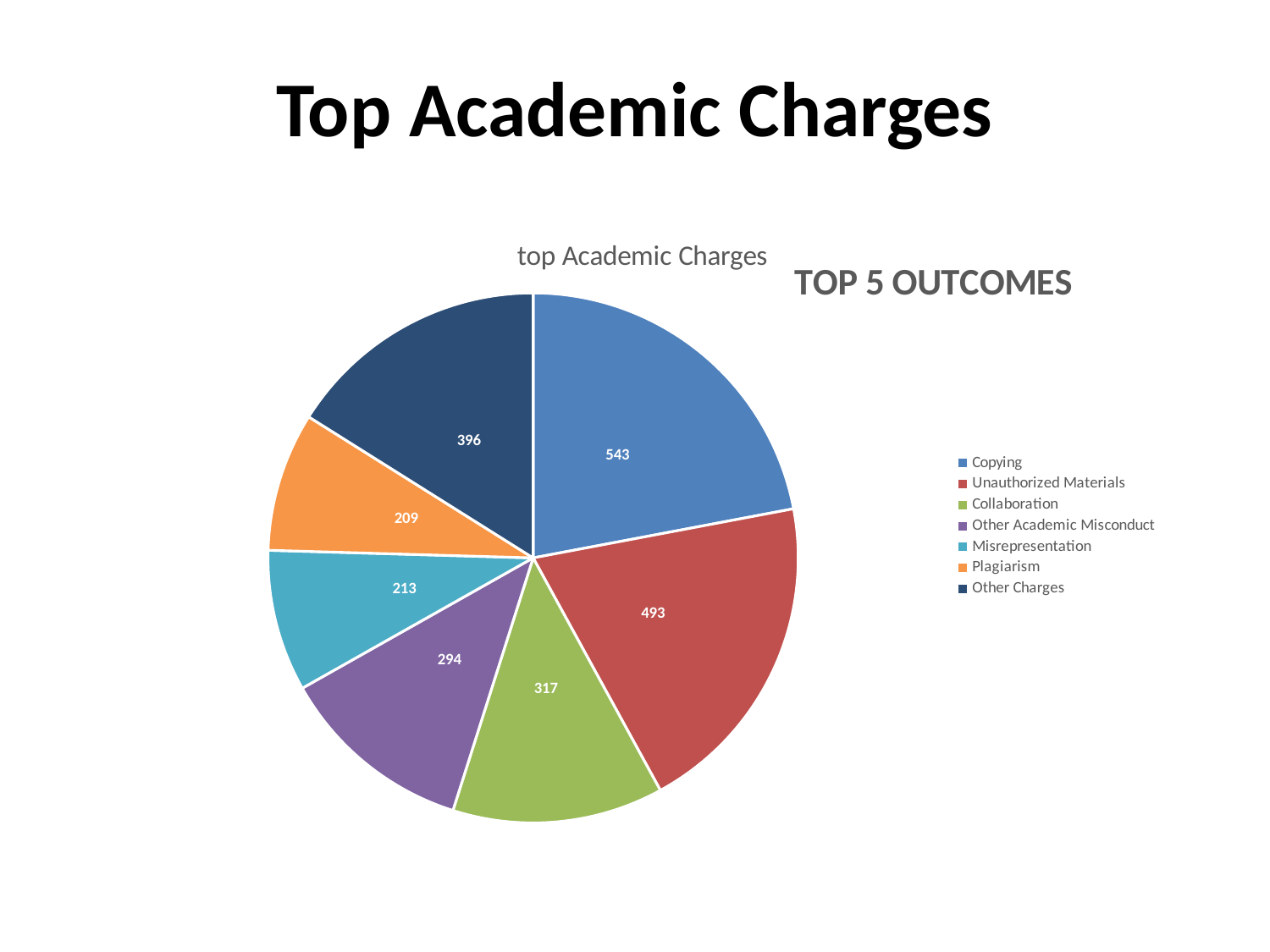
What is the value for Unauthorized Materials? 493 What is the value for Copying? 543 What is the difference between the values for Copying and Unauthorized Materials? 50 Which category has the smallest slice? Plagiarism What is the value for Misrepresentation? 213 What is the difference between the values for Other Charges and Plagiarism? 187 Which category has the largest slice? Copying What is the value for Other Charges? 396 How many categories does the pie chart show? 7 What type of chart is shown on the slide? pie chart Which is larger, Collaboration or Other Academic Misconduct? Collaboration What is the title of the pie chart? top Academic Charges